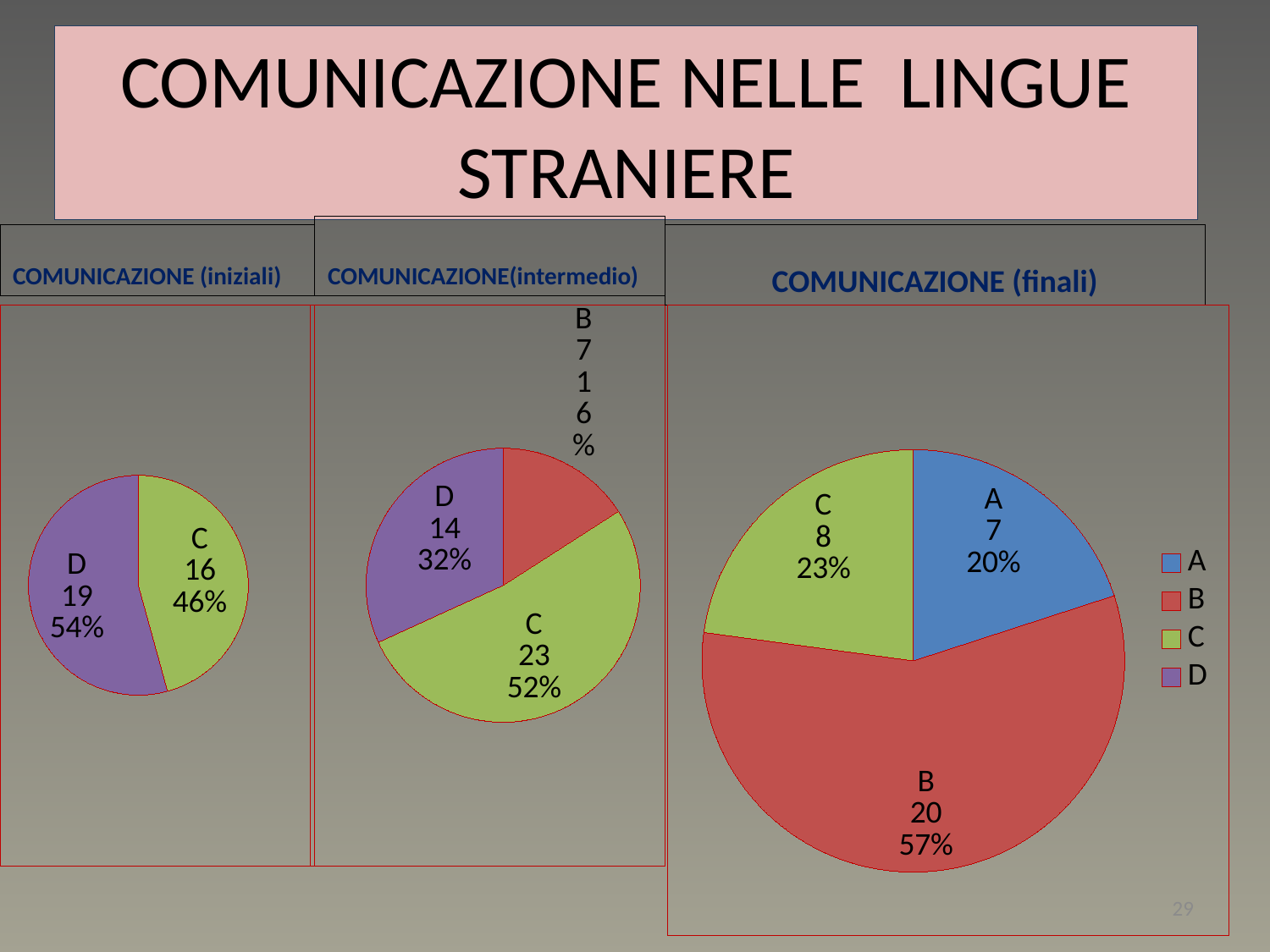
How many entries does the legend of the COMUNICAZIONE (finali) chart list? 4 What kind of chart is the COMUNICAZIONE (finali) chart? Pie chart In the COMUNICAZIONE (finali) chart, what share of the pie does A represent? 20% In the COMUNICAZIONE(intermedio) chart, what is the value for C? 23 In the COMUNICAZIONE (finali) chart, what is the value for B? 20 In the COMUNICAZIONE(intermedio) chart, which category is the smallest? B In the COMUNICAZIONE(intermedio) chart, what share of the pie does D represent? 32% In the COMUNICAZIONE (finali) chart, which is larger, the value for A or the value for C? C In the COMUNICAZIONE(intermedio) chart, what is the difference between the values for C and D? 9 In the COMUNICAZIONE (iniziali) chart, what share of the pie does C represent? 46% In the COMUNICAZIONE (iniziali) chart, what is the value for D? 19 In the COMUNICAZIONE (iniziali) chart, which category is the largest? D